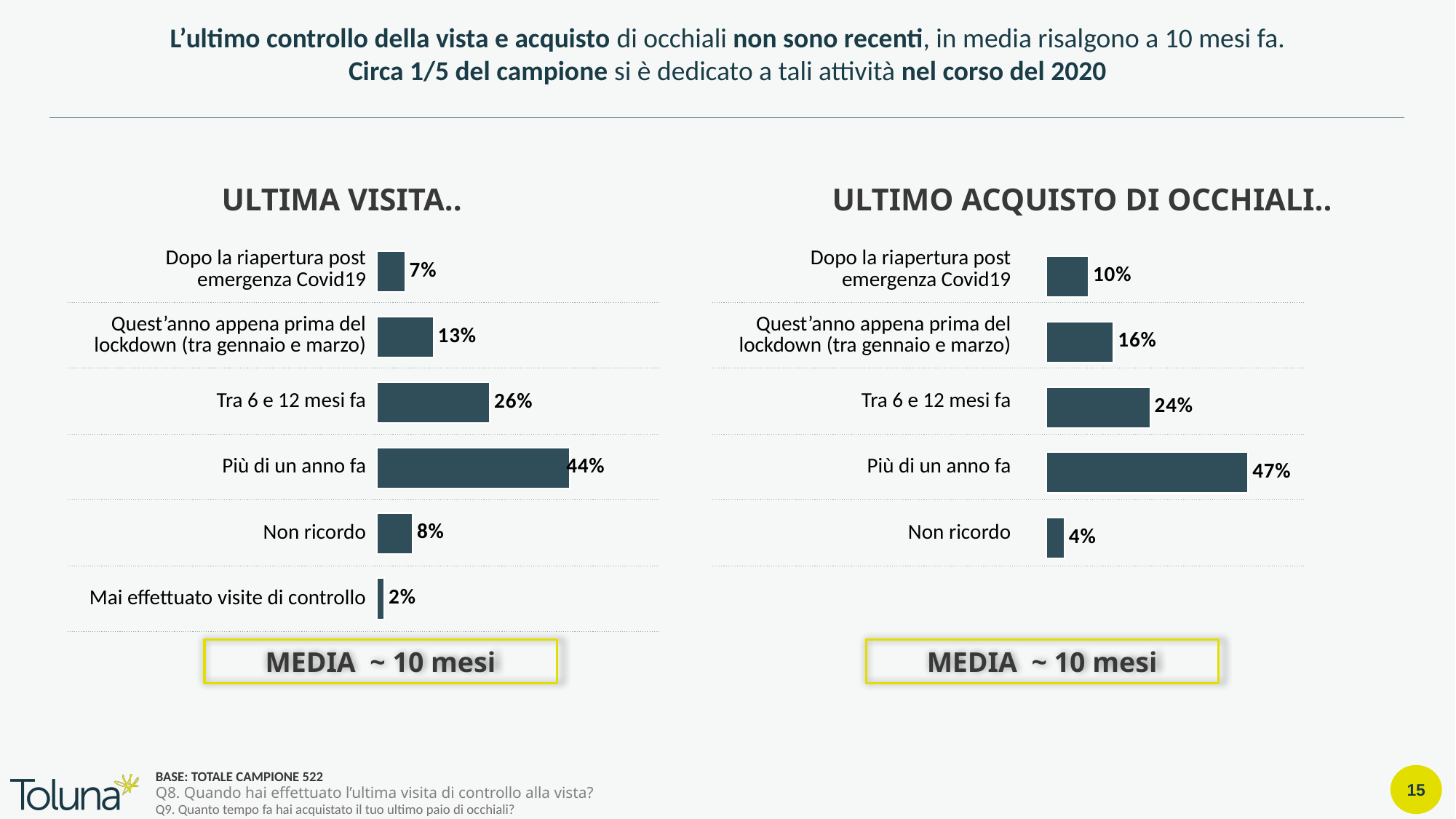
How many categories does the 'ULTIMO ACQUISTO DI OCCHIALI..' chart show? 5 In the 'ULTIMO ACQUISTO DI OCCHIALI..' chart, what is the value for 'Quest'anno appena prima del lockdown (tra gennaio e marzo)'? 16% In the 'ULTIMA VISITA..' chart, what is the total of 'Dopo la riapertura post emergenza Covid19' and 'Quest'anno appena prima del lockdown (tra gennaio e marzo)'? 20% In the 'ULTIMA VISITA..' chart, which category has the highest value? Più di un anno fa In the 'ULTIMA VISITA..' chart, which category has the lowest value? Mai effettuato visite di controllo In the 'ULTIMA VISITA..' chart, which is larger: 'Non ricordo' or 'Dopo la riapertura post emergenza Covid19'? Non ricordo In the 'ULTIMA VISITA..' chart, what is the value for 'Tra 6 e 12 mesi fa'? 26% What kind of chart is the 'ULTIMO ACQUISTO DI OCCHIALI..' chart? Bar chart How many categories does the 'ULTIMA VISITA..' chart show? 6 What average ('MEDIA') is shown below the 'ULTIMO ACQUISTO DI OCCHIALI..' chart? ~ 10 mesi In the 'ULTIMO ACQUISTO DI OCCHIALI..' chart, what is the difference between 'Più di un anno fa' and 'Tra 6 e 12 mesi fa'? 23% In the 'ULTIMO ACQUISTO DI OCCHIALI..' chart, which category has the lowest value? Non ricordo